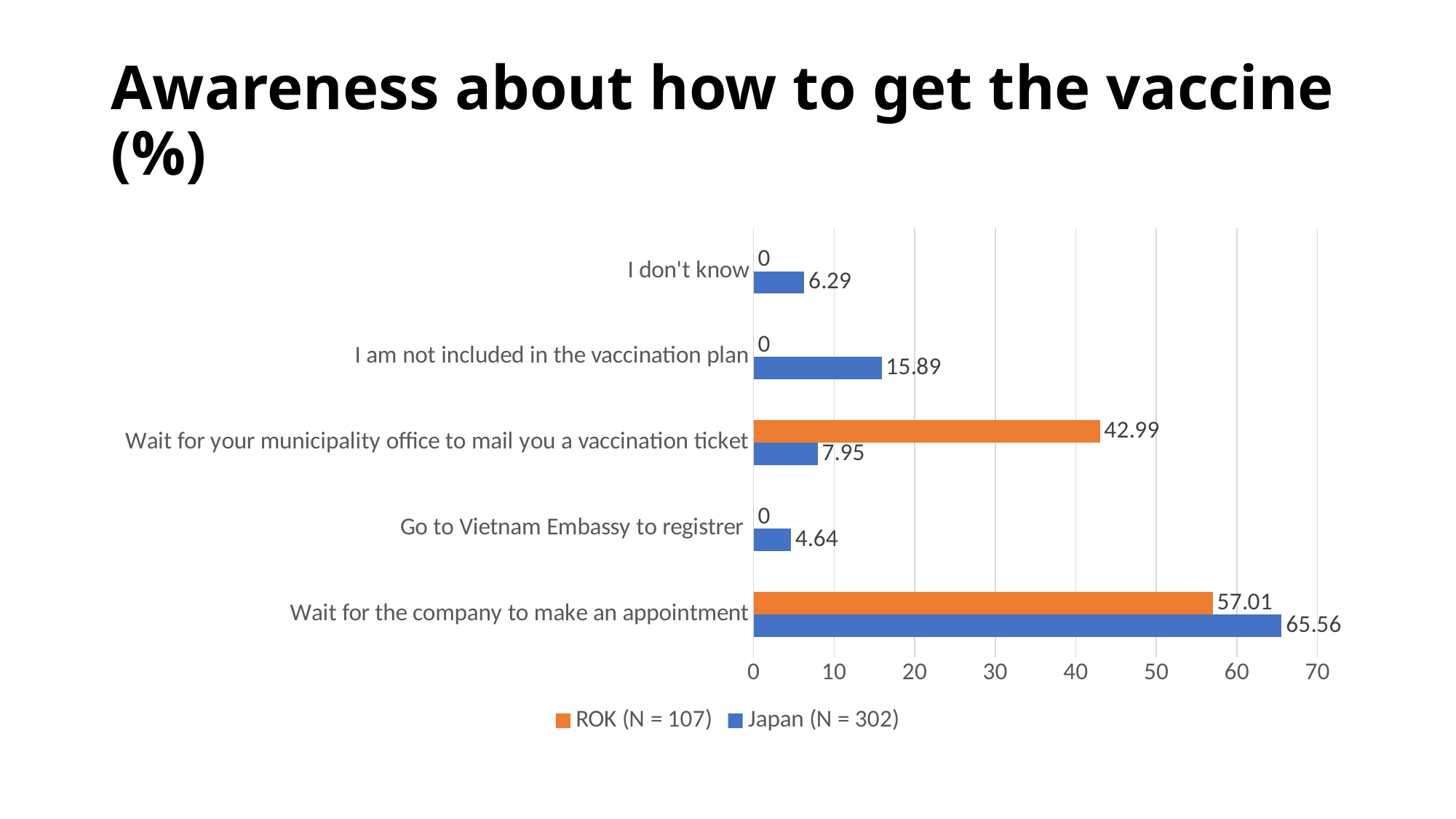
What is the difference between the Japan (N = 302) and ROK (N = 107) values for 'Wait for the company to make an appointment'? 8.55 What is the value for Japan (N = 302) for 'Wait for the company to make an appointment'? 65.56 For 'Wait for your municipality office to mail you a vaccination ticket', which series has the larger value, ROK (N = 107) or Japan (N = 302)? ROK (N = 107) Which category has the highest value for Japan (N = 302)? Wait for the company to make an appointment What colour represents the ROK (N = 107) series? Orange Which category has the lowest value for Japan (N = 302)? Go to Vietnam Embassy to registrer What is the value for Japan (N = 302) for 'I am not included in the vaccination plan'? 15.89 How many series does the legend list? 2 What kind of chart is shown on the slide? Bar chart What is the value for ROK (N = 107) for 'Wait for your municipality office to mail you a vaccination ticket'? 42.99 How many categories are shown on the chart? 5 What is the value for ROK (N = 107) for 'Go to Vietnam Embassy to registrer'? 0